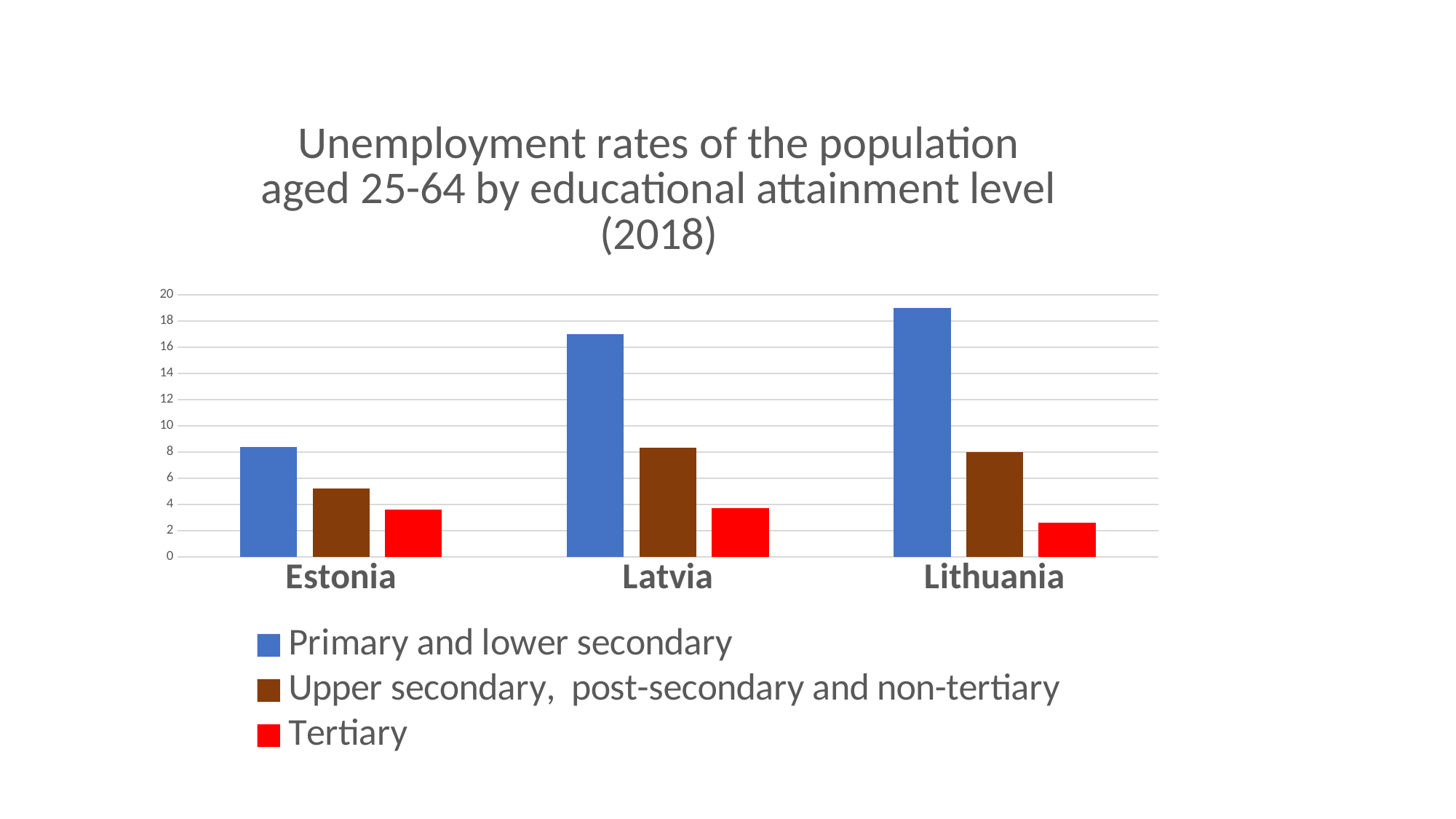
Which colour represents the Tertiary series in the legend? red Which is larger: the Primary and lower secondary value for Estonia or the Tertiary value for Estonia? Primary and lower secondary Is the Primary and lower secondary value for Lithuania greater or less than 18? greater Which country has the lowest unemployment rate for Primary and lower secondary? Estonia What kind of chart is shown on the slide? bar chart Is the Tertiary value for Estonia greater or less than 4? less How many countries are shown on the x axis? 3 Which country has the highest unemployment rate for Primary and lower secondary? Lithuania How many series does the legend list? 3 Is the Primary and lower secondary value for Latvia greater or less than 16? greater Which country has the lowest unemployment rate for Tertiary? Lithuania Which is larger: the Upper secondary, post-secondary and non-tertiary value for Estonia or for Latvia? Latvia